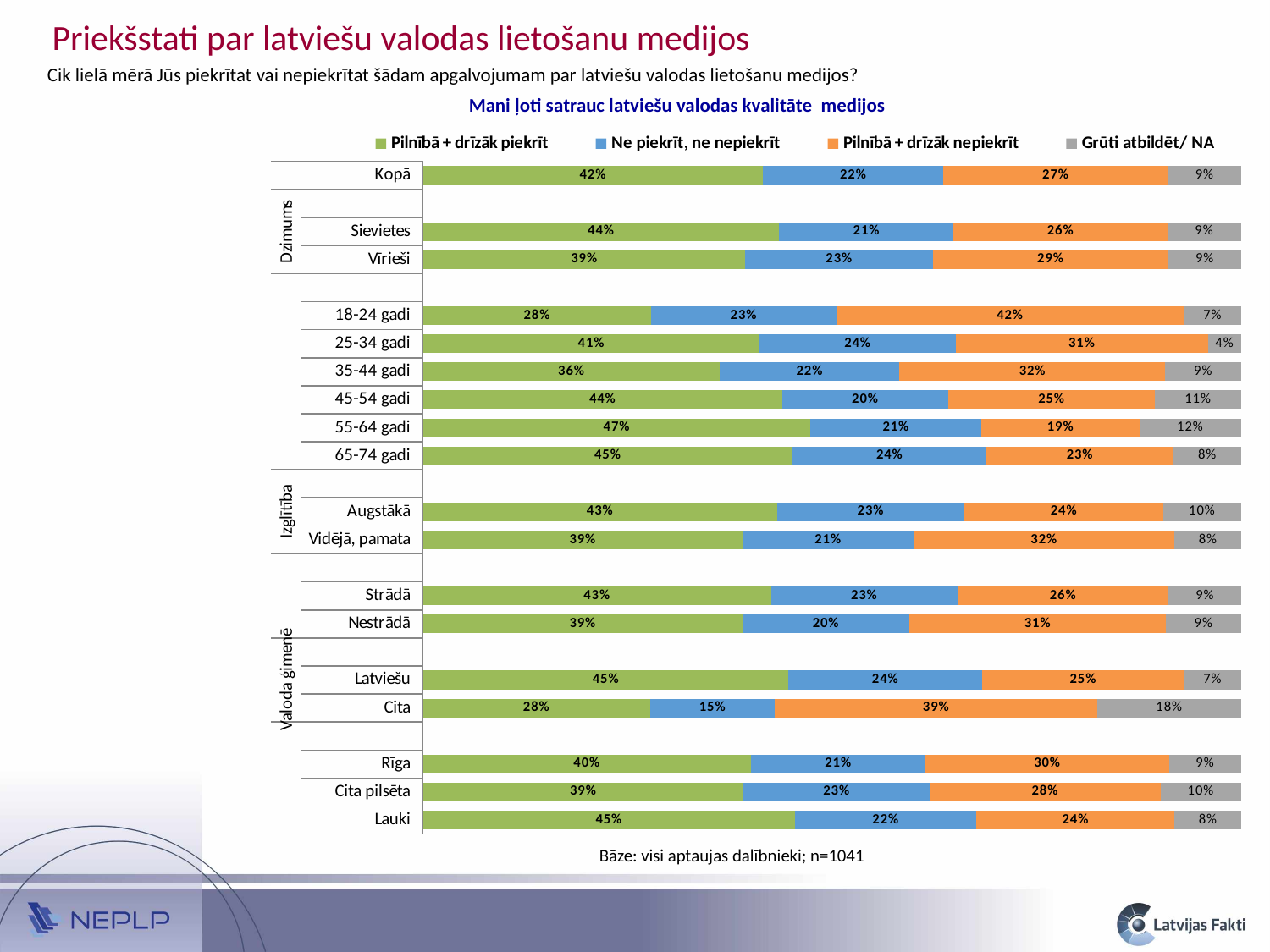
What is the value for "Grūti atbildēt/ NA" in the Cita row? 18% What is the value for "Pilnībā + drīzāk nepiekrīt" in the 18-24 gadi row? 42% How many category rows are plotted in the chart? 18 What is the title of the chart? Mani ļoti satrauc latviešu valodas kvalitāte medijos How many series does the legend list? 4 What is the difference between the "Pilnībā + drīzāk piekrīt" values for Sievietes and Vīrieši? 5% What kind of chart is shown on the slide? Stacked bar chart Which is larger: the "Pilnībā + drīzāk nepiekrīt" value for Rīga or for Lauki? Rīga Which category has the lowest value for "Ne piekrīt, ne nepiekrīt"? Cita What is the value for "Pilnībā + drīzāk piekrīt" in the Kopā row? 42% Which category has the highest value for "Pilnībā + drīzāk piekrīt"? 55-64 gadi Which category has the highest value for "Pilnībā + drīzāk nepiekrīt"? 18-24 gadi